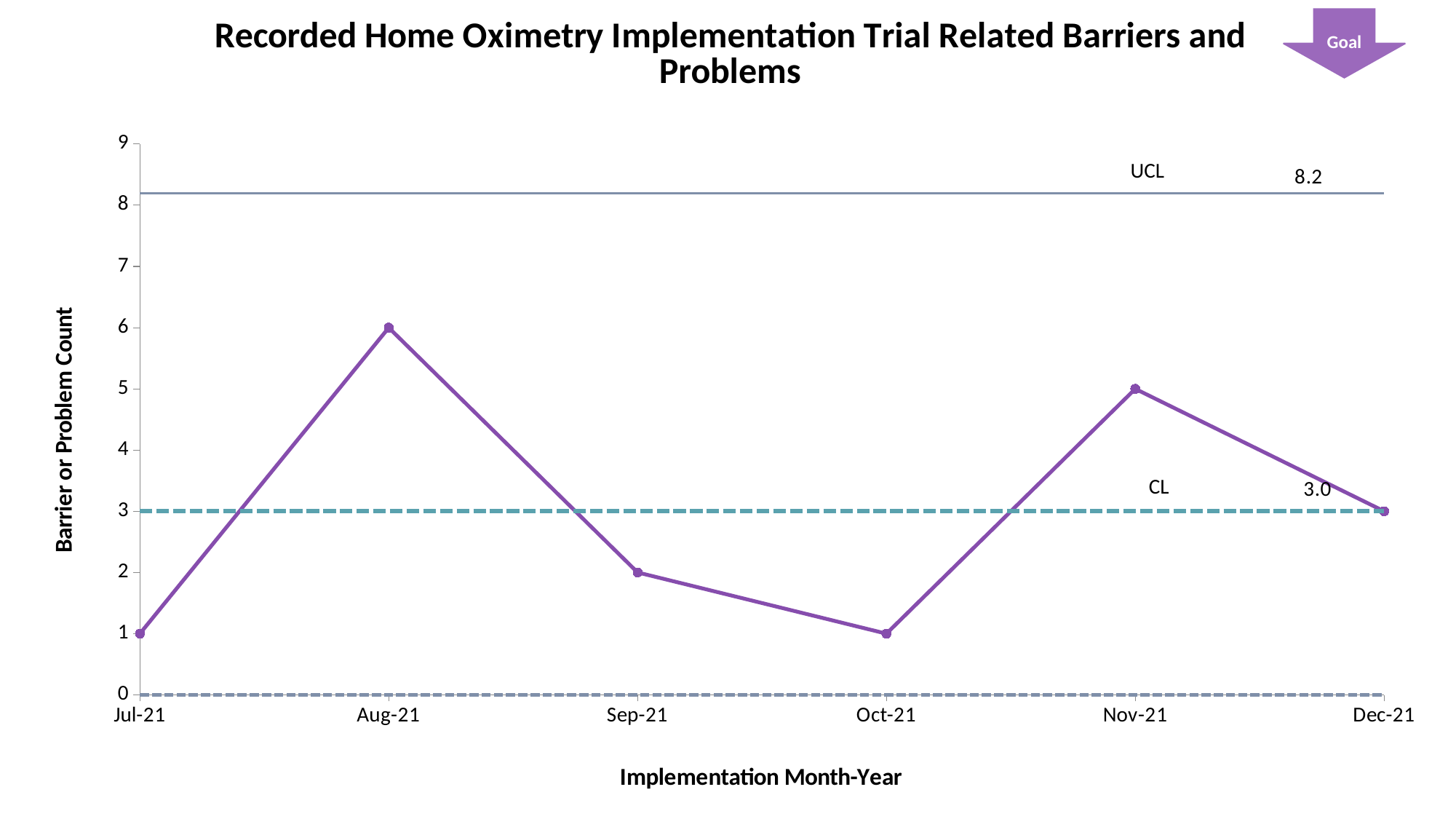
How many months are plotted on the x axis? 6 What is the Barrier or Problem Count for Dec-21? 3 What is the Barrier or Problem Count for Aug-21? 6 What is the value of the UCL line? 8.2 What is the title of the chart? Recorded Home Oximetry Implementation Trial Related Barriers and Problems Which month has the highest Barrier or Problem Count? Aug-21 What is the value of the CL line? 3.0 Which is larger, the Barrier or Problem Count for Nov-21 or Oct-21? Nov-21 What is the difference between the Barrier or Problem Count for Aug-21 and Sep-21? 4 Does the Barrier or Problem Count rise or fall from Nov-21 to Dec-21? fall What type of chart is shown on the slide? line chart What is the Barrier or Problem Count for Nov-21? 5